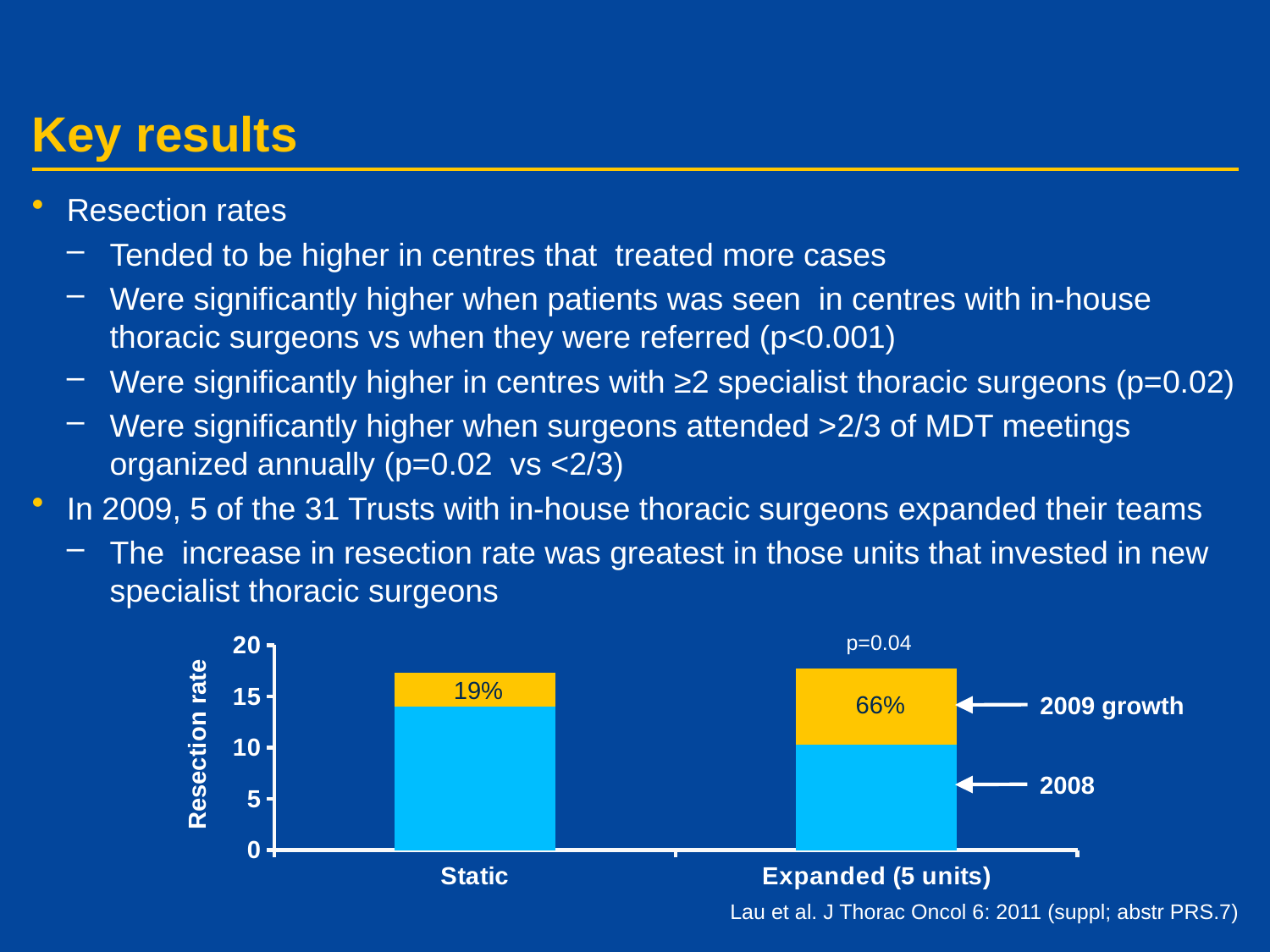
How many series does the chart distinguish (as labelled by the arrows)? 2 What percentage label is printed on the 2009 growth segment of the Static bar? 19% Which category has the larger 2009 growth segment, Static or Expanded (5 units)? Expanded (5 units) How many categories are shown on the x axis of the chart? 2 What p-value is printed above the Expanded (5 units) bar? p=0.04 Is the 2008 segment of the Static bar greater or less than 10 on the resection rate axis? greater What is the label on the y axis of the chart? Resection rate Is the total height of the Static bar greater or less than 15 on the resection rate axis? greater What kind of chart is shown on the slide? Stacked bar chart What percentage label is printed on the 2009 growth segment of the Expanded (5 units) bar? 66% Which category has the larger 2008 segment, Static or Expanded (5 units)? Static Is the 2008 segment of the Expanded (5 units) bar greater or less than 15 on the resection rate axis? less